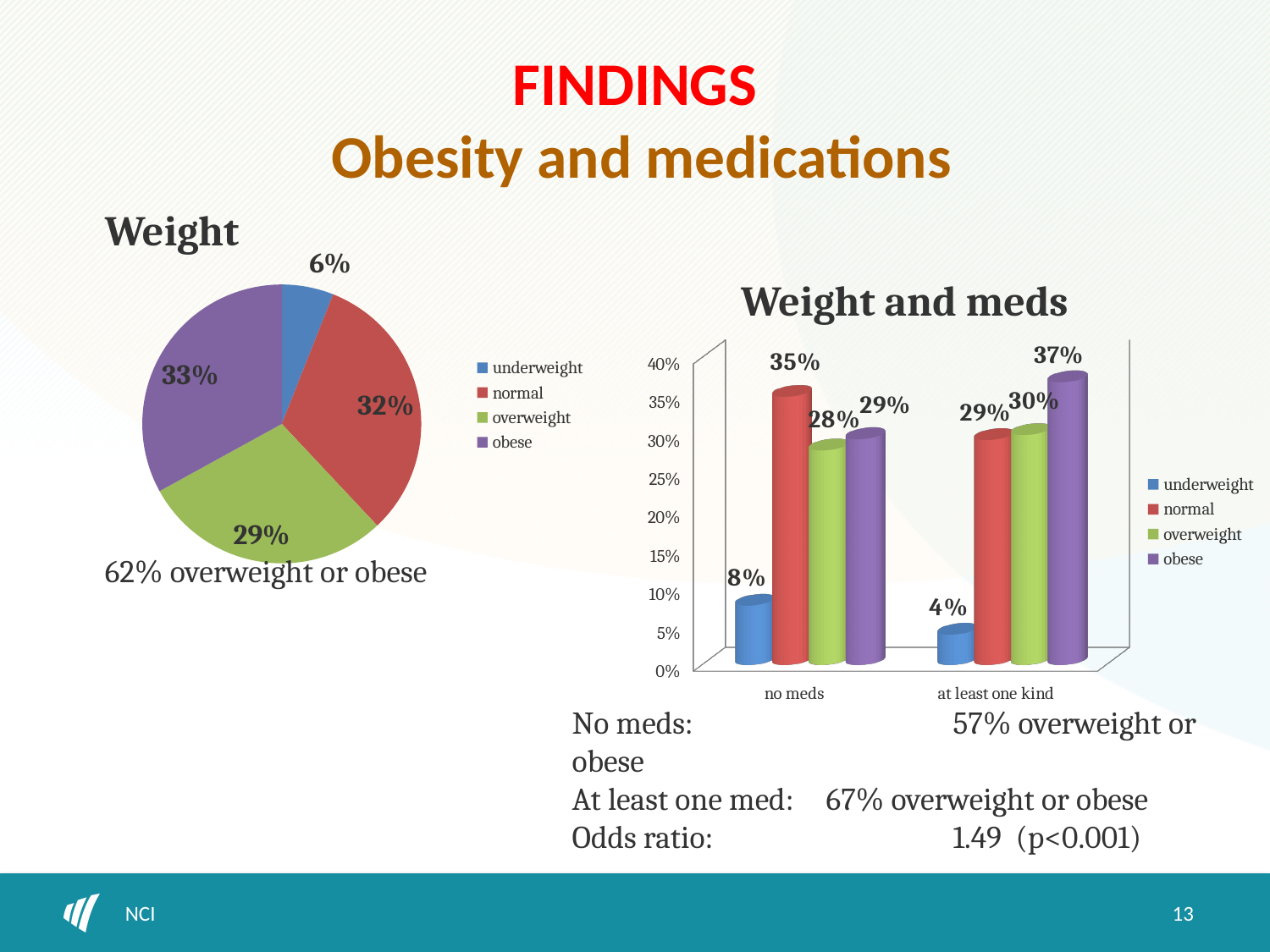
In the "Weight and meds" chart, how many series does the legend list? 4 In the "Weight and meds" chart, what is the difference between the underweight values for no meds and at least one kind? 4% In the "Weight" pie chart, which category has the smallest slice? underweight What kind of chart is "Weight and meds"? bar chart In the "Weight and meds" chart, which is larger: obese for no meds or obese for at least one kind? at least one kind In the "Weight" pie chart, which category has the largest slice? obese In the "Weight" pie chart, how many slices are there? 4 In the "Weight" pie chart, what share is labelled for the underweight slice? 6% In the "Weight" pie chart, what share is labelled for the obese slice? 33% In the "Weight and meds" chart, which series is the lowest in the no meds group? underweight In the "Weight and meds" chart, what is the value for normal in the no meds group? 35% In the "Weight and meds" chart, what is the value for obese in the at least one kind group? 37%